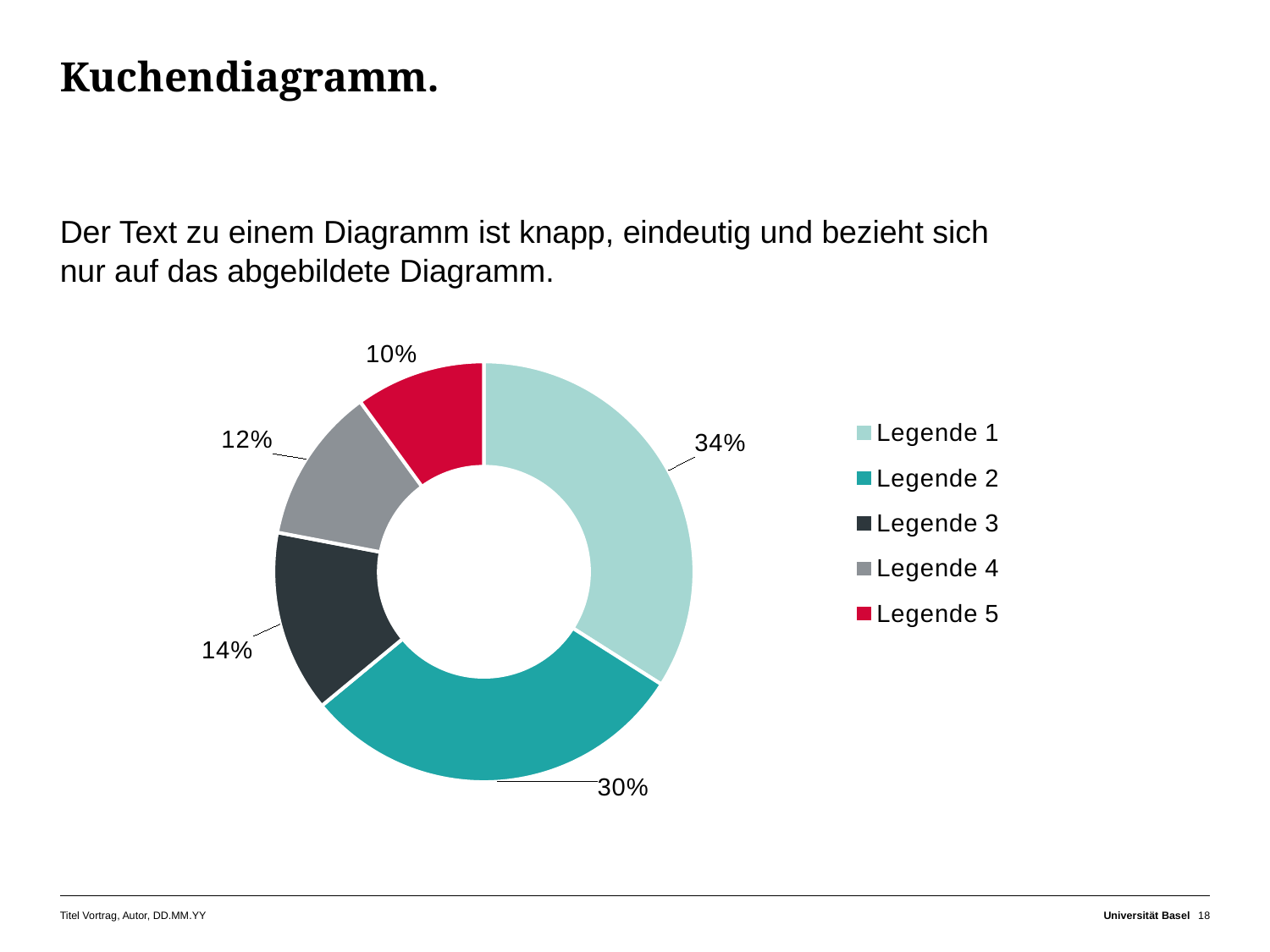
What share of the pie does Legende 5 have? 10% Which category has the smallest share of the pie? Legende 5 Which category has the largest share of the pie? Legende 1 What share of the pie does Legende 4 have? 12% What colour is the slice for Legende 5? Red What share of the pie does Legende 3 have? 14% How many slices does the pie chart have? 5 Which has a larger share, Legende 3 or Legende 4? Legende 3 What share of the pie does Legende 2 have? 30% What share of the pie does Legende 1 have? 34% What is the difference in percentage points between Legende 1 and Legende 2? 4 What kind of chart is shown on the slide? Pie chart (doughnut)